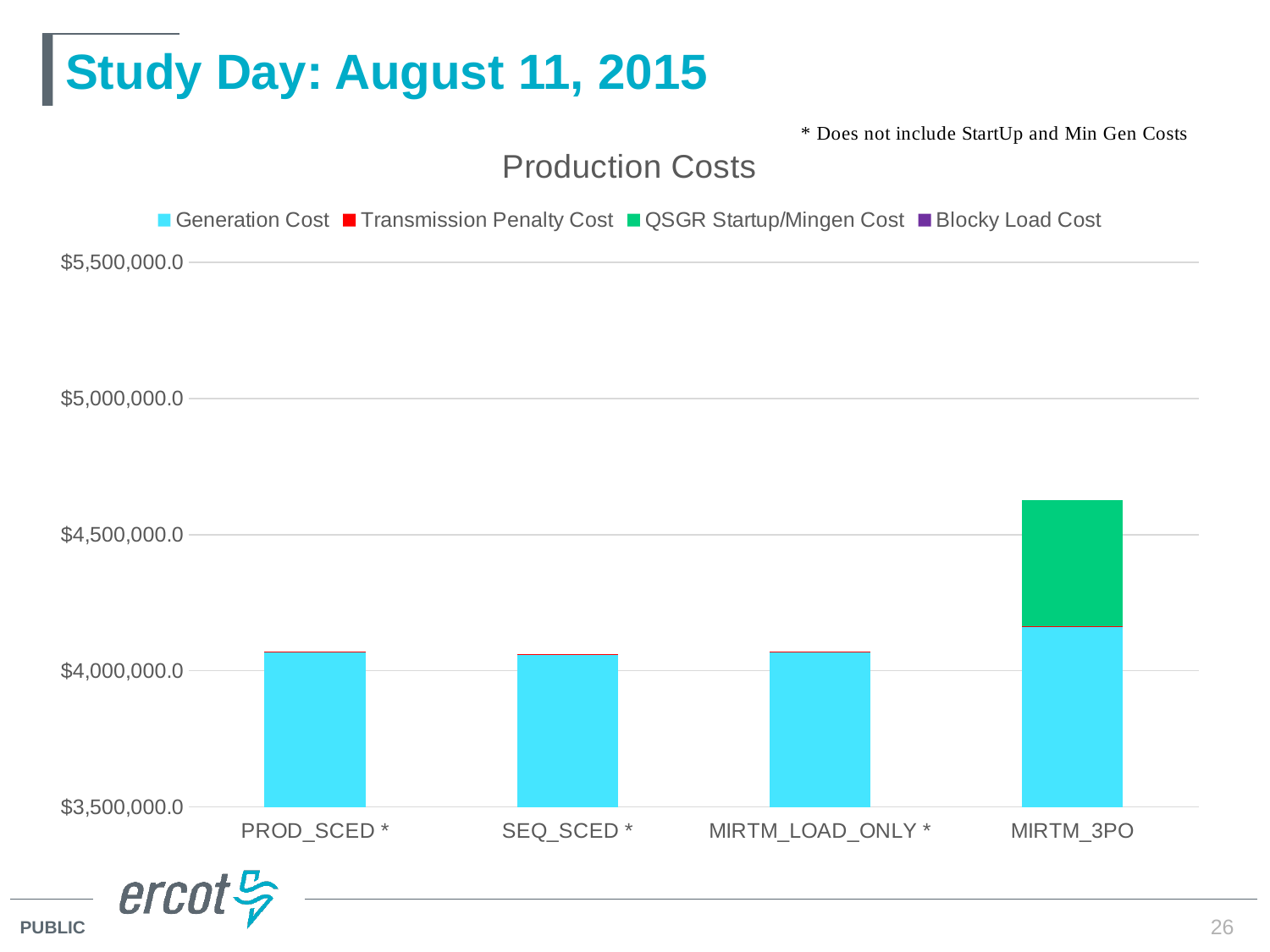
Which category is the only one with a visible QSGR Startup/Mingen Cost segment? MIRTM_3PO Which category has the highest total production cost? MIRTM_3PO Is the total value for PROD_SCED * greater or less than $4,000,000.0? greater What kind of chart is shown on the slide? Stacked bar chart Is the total value for SEQ_SCED * greater or less than $4,500,000.0? less Which has a larger total production cost, MIRTM_3PO or SEQ_SCED *? MIRTM_3PO Which series is shown in green in the legend? QSGR Startup/Mingen Cost How many categories are shown on the x axis? 4 What is the title of the chart? Production Costs Is the Generation Cost for MIRTM_3PO greater or less than $4,500,000.0? less How many series does the legend list? 4